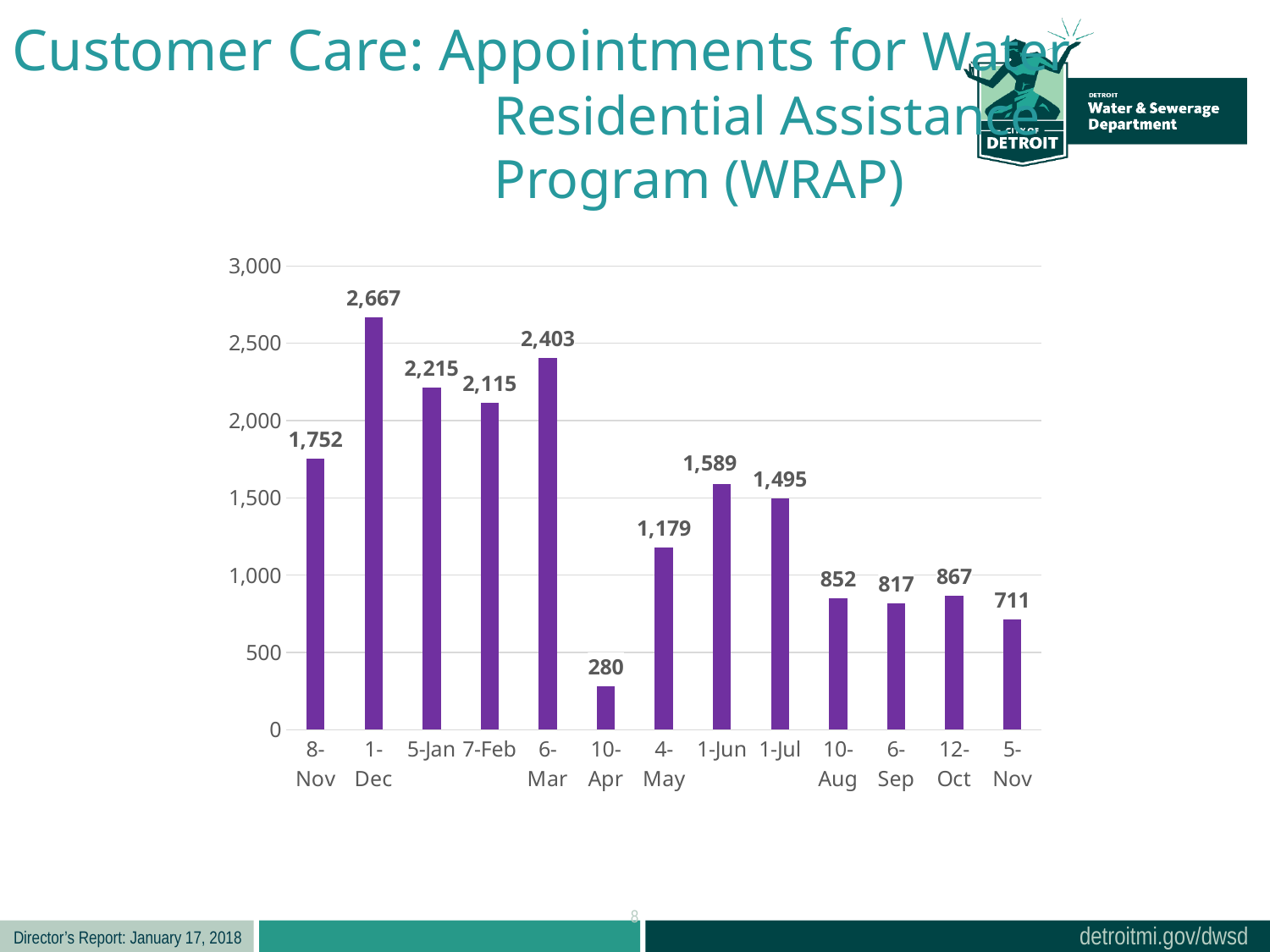
What is the value for 1-Jul? 1,495 Is the value for 4-May greater or less than 1,000? greater What is the difference between the values for 1-Dec and 5-Nov? 1,956 Which category has the lowest value? 10-Apr Which is larger, the value for 6-Mar or the value for 5-Jan? 6-Mar Do the values generally rise or fall from 1-Jun to 5-Nov? fall What kind of chart is shown on the slide? bar chart What is the value for 1-Dec? 2,667 Which category has the highest value? 1-Dec How many categories are shown on the x axis? 13 What is the value for 10-Apr? 280 What is the value for 12-Oct? 867